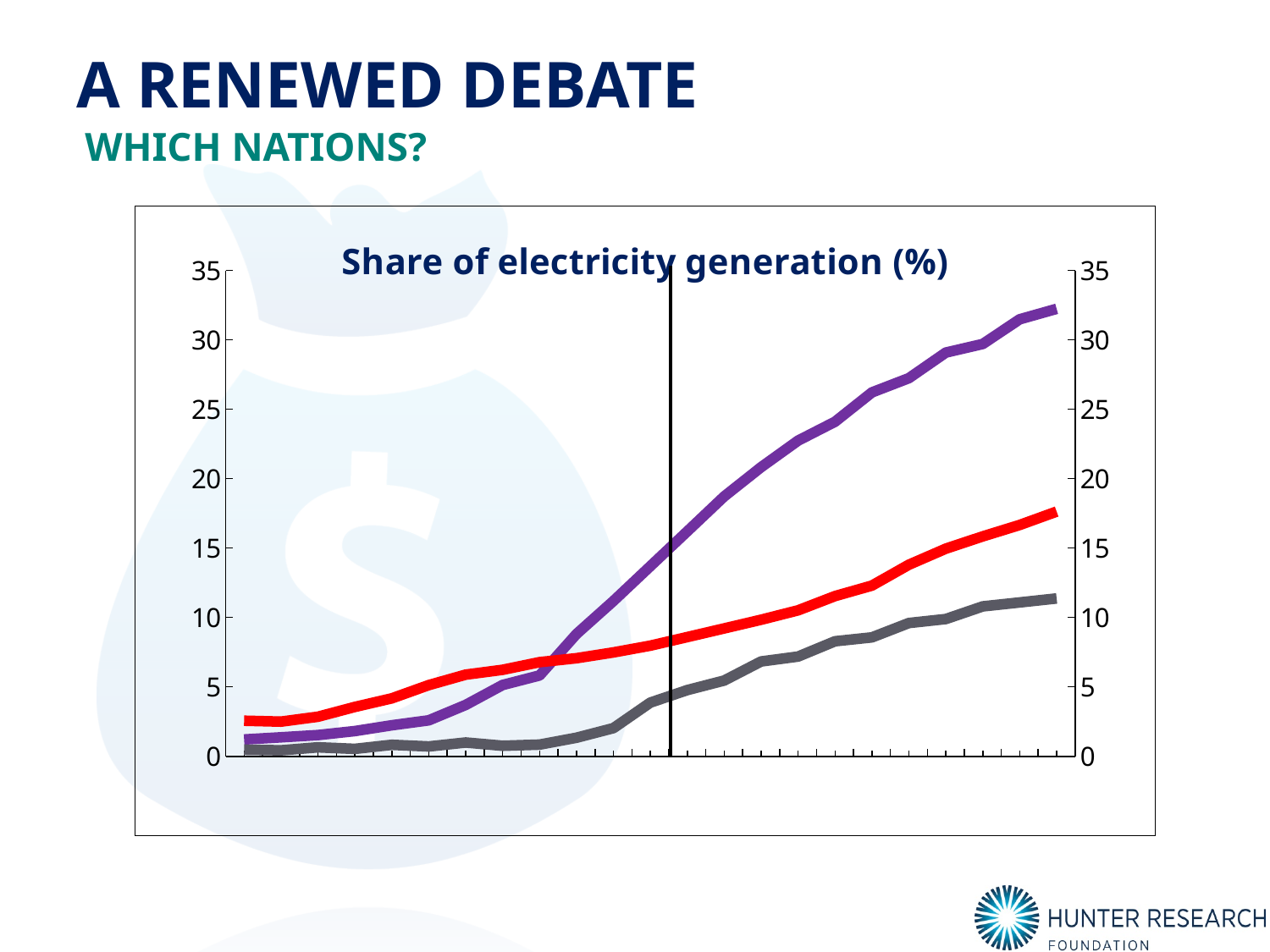
Is the value of the purple line at the left end of the chart greater or less than 5? less Does the red line generally rise or fall from left to right? rise How many lines are plotted on the chart? 3 What is the maximum value shown on the vertical axis? 35 What kind of chart is shown on the slide? line chart At the left end of the chart, which line is higher: the red line or the purple line? the red line Is the value of the red line at the right end of the chart greater or less than 15? greater Does the purple line generally rise or fall from left to right? rise What is the title of the chart? Share of electricity generation (%) Which line reaches the highest value at the right end of the chart? the purple line Which line has the lowest value at the right end of the chart? the grey line Is the value of the purple line at the right end of the chart greater or less than 30? greater